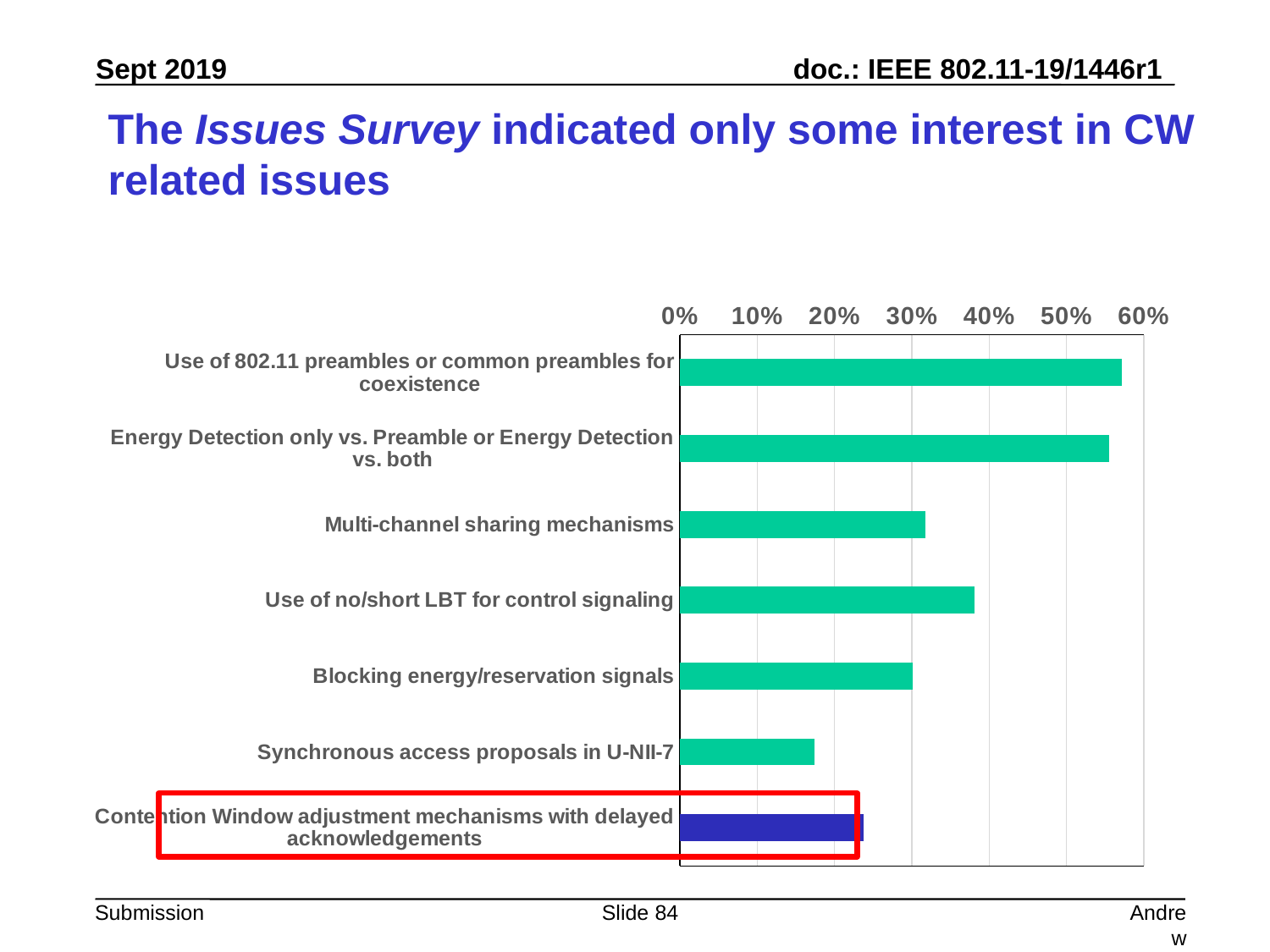
Is the value for 'Use of 802.11 preambles or common preambles for coexistence' greater or less than 50%? greater Which has a larger value: 'Multi-channel sharing mechanisms' or 'Synchronous access proposals in U-NII-7'? Multi-channel sharing mechanisms Which category has the lowest value in the chart? Synchronous access proposals in U-NII-7 What is the highest value shown on the percentage axis of the chart? 60% Which category's bar is drawn in a different colour (dark blue) and outlined with a red box? Contention Window adjustment mechanisms with delayed acknowledgements How many categories are plotted in the chart? 7 Is the value for 'Energy Detection only vs. Preamble or Energy Detection vs. both' greater or less than 50%? greater Is the value for 'Synchronous access proposals in U-NII-7' greater or less than 20%? less Which has a larger value: 'Use of no/short LBT for control signaling' or 'Blocking energy/reservation signals'? Use of no/short LBT for control signaling What kind of chart is shown on the slide? bar chart